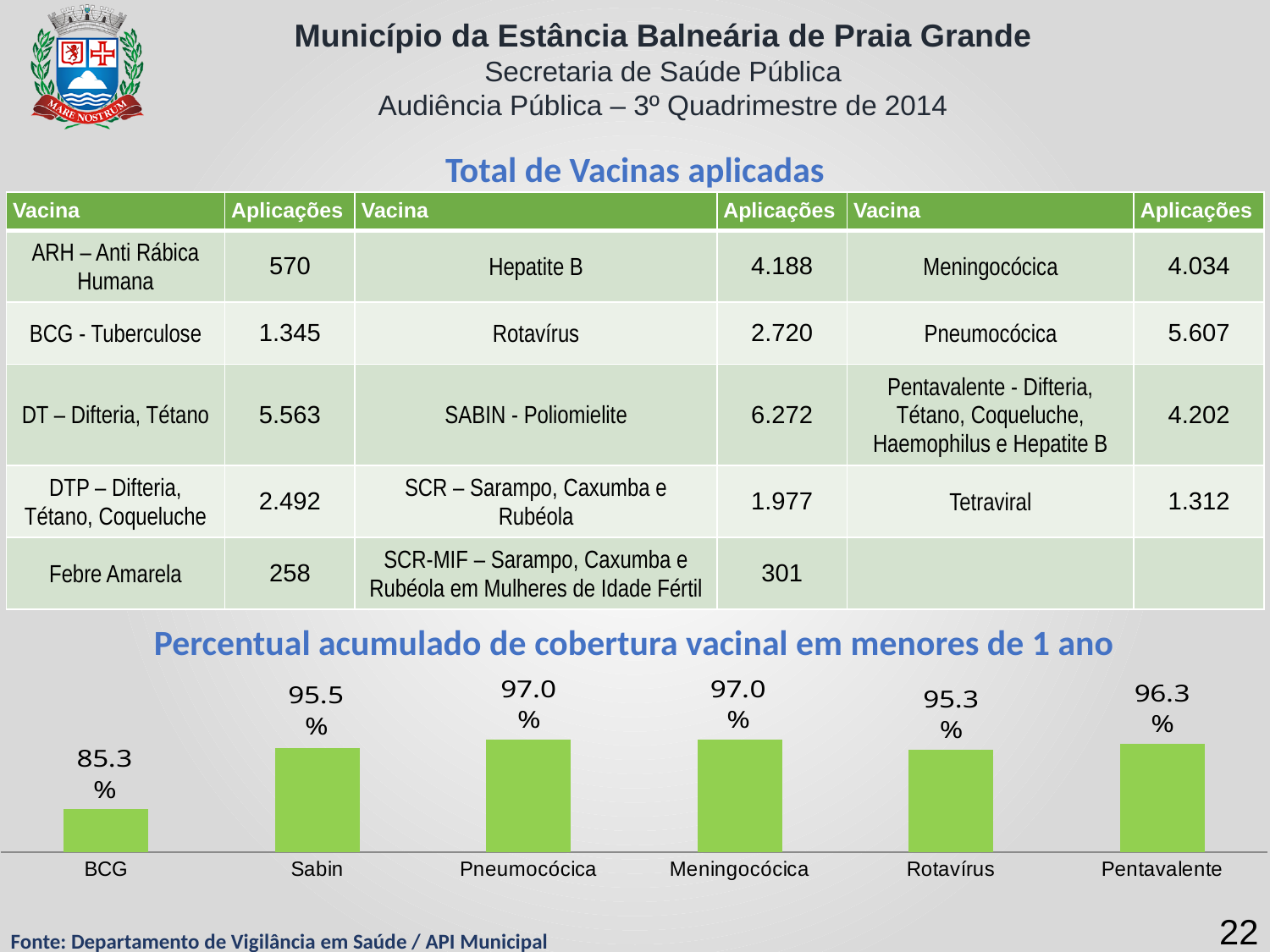
How many categories are shown in the chart 'Percentual acumulado de cobertura vacinal em menores de 1 ano'? 6 In the chart 'Percentual acumulado de cobertura vacinal em menores de 1 ano', which is larger, the value for Pentavalente or the value for BCG? Pentavalente In the chart 'Percentual acumulado de cobertura vacinal em menores de 1 ano', what is the difference between the values for Pentavalente and Rotavírus? 1.0 percentage point Which category has the lowest value in the chart 'Percentual acumulado de cobertura vacinal em menores de 1 ano'? BCG What is the value for BCG in the chart 'Percentual acumulado de cobertura vacinal em menores de 1 ano'? 85.3% What kind of chart is 'Percentual acumulado de cobertura vacinal em menores de 1 ano'? Bar chart What is the value for Pentavalente in the chart 'Percentual acumulado de cobertura vacinal em menores de 1 ano'? 96.3% What is the value for Rotavírus in the chart 'Percentual acumulado de cobertura vacinal em menores de 1 ano'? 95.3% What colour are the bars in the chart 'Percentual acumulado de cobertura vacinal em menores de 1 ano'? Green What is the value for Sabin in the chart 'Percentual acumulado de cobertura vacinal em menores de 1 ano'? 95.5% What is the value for Meningocócica in the chart 'Percentual acumulado de cobertura vacinal em menores de 1 ano'? 97.0% In the chart 'Percentual acumulado de cobertura vacinal em menores de 1 ano', what is the difference between the values for Pneumocócica and BCG? 11.7 percentage points